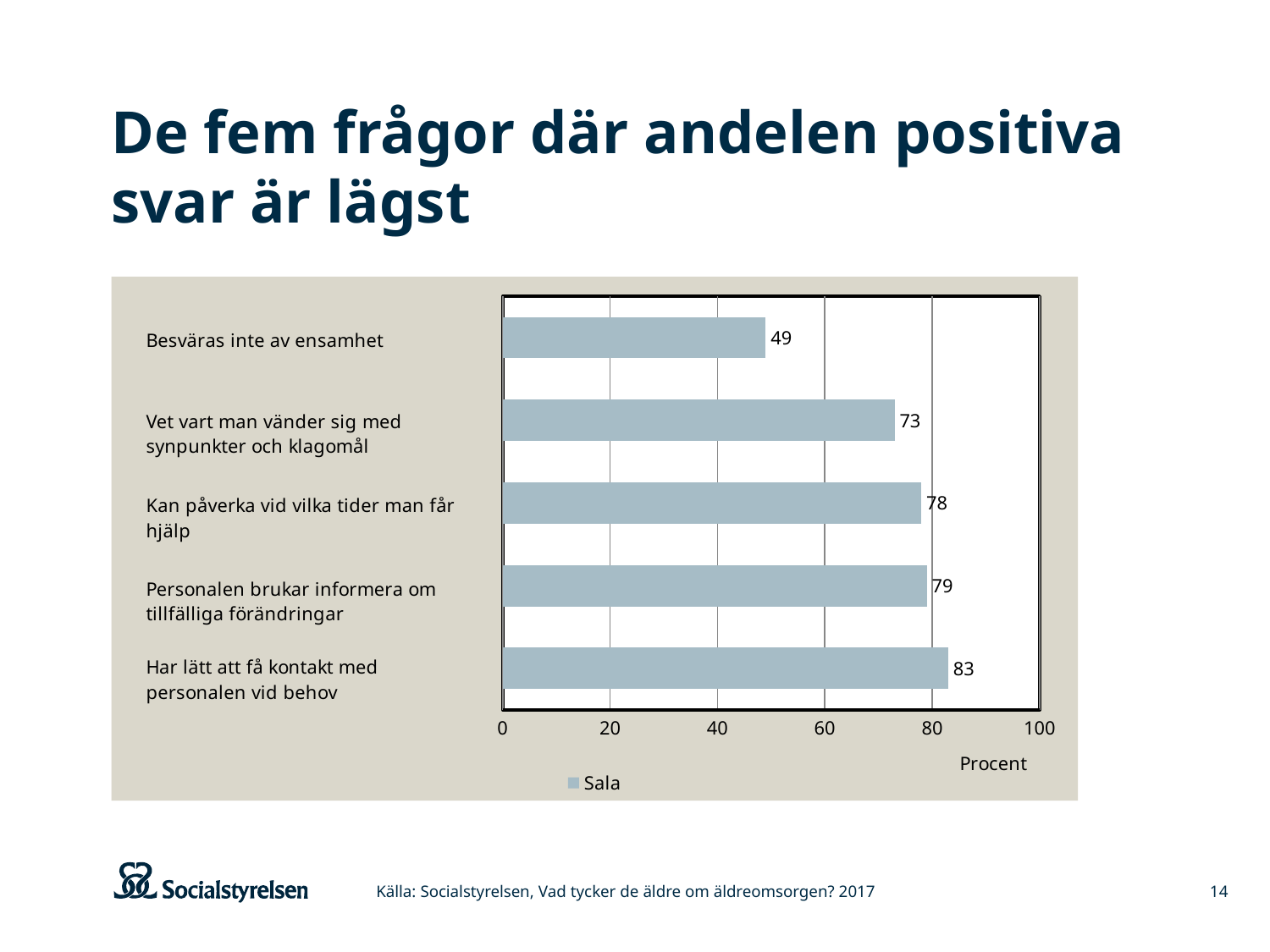
What is the value for "Kan påverka vid vilka tider man får hjälp"? 78 What is the difference between the values for "Har lätt att få kontakt med personalen vid behov" and "Besväras inte av ensamhet"? 34 Which category has the lowest value? Besväras inte av ensamhet Is the value for "Personalen brukar informera om tillfälliga förändringar" greater or less than 60? greater What is the value for "Har lätt att få kontakt med personalen vid behov"? 83 What kind of chart is shown on the slide? bar chart What is the name of the series in the legend? Sala How many series does the legend list? 1 Which category has the highest value? Har lätt att få kontakt med personalen vid behov Which is larger: the value for "Vet vart man vänder sig med synpunkter och klagomål" or for "Kan påverka vid vilka tider man får hjälp"? Kan påverka vid vilka tider man får hjälp How many categories are shown in the chart? 5 What is the value for "Besväras inte av ensamhet"? 49